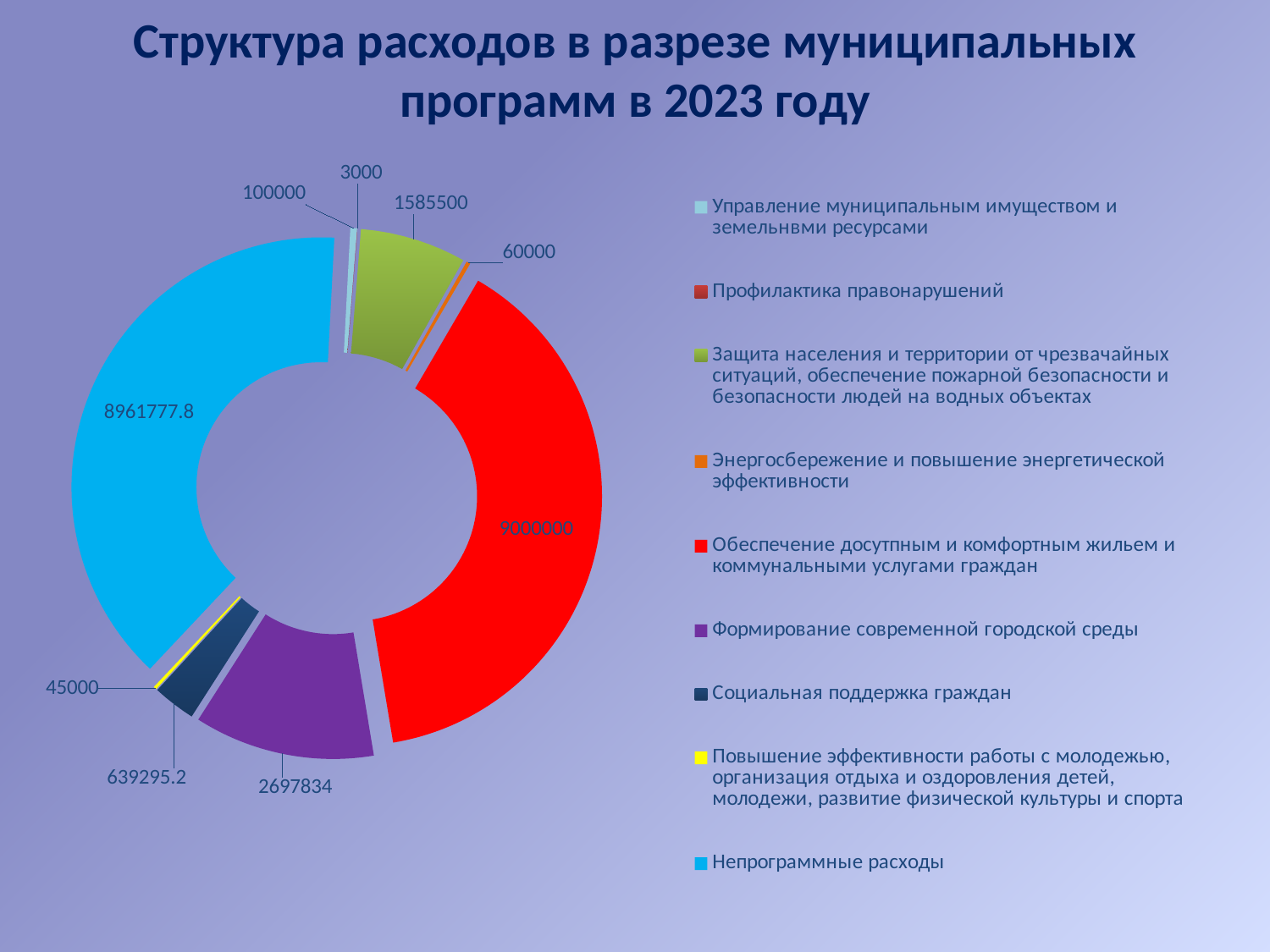
What is the value for Профилактика правонарушений? 3000 What is the title of the chart? Структура расходов в разрезе муниципальных программ в 2023 году Which category has the lowest value? Профилактика правонарушений What is the value for Энергосбережение и повышение энергетической эффективности? 60000 What is the value for Социальная поддержка граждан? 639295.2 What kind of chart is shown on the slide? doughnut chart What is the difference between the values for Обеспечение доступным и комфортным жильем и коммунальными услугами граждан and Непрограммные расходы? 38222.2 Which is larger: the value for Защита населения и территории от чрезвычайных ситуаций or the value for Формирование современной городской среды? Формирование современной городской среды How many categories does the chart show? 9 What is the value for Формирование современной городской среды? 2697834 What is the value for Непрограммные расходы? 8961777.8 Which category has the highest value? Обеспечение доступным и комфортным жильем и коммунальными услугами граждан